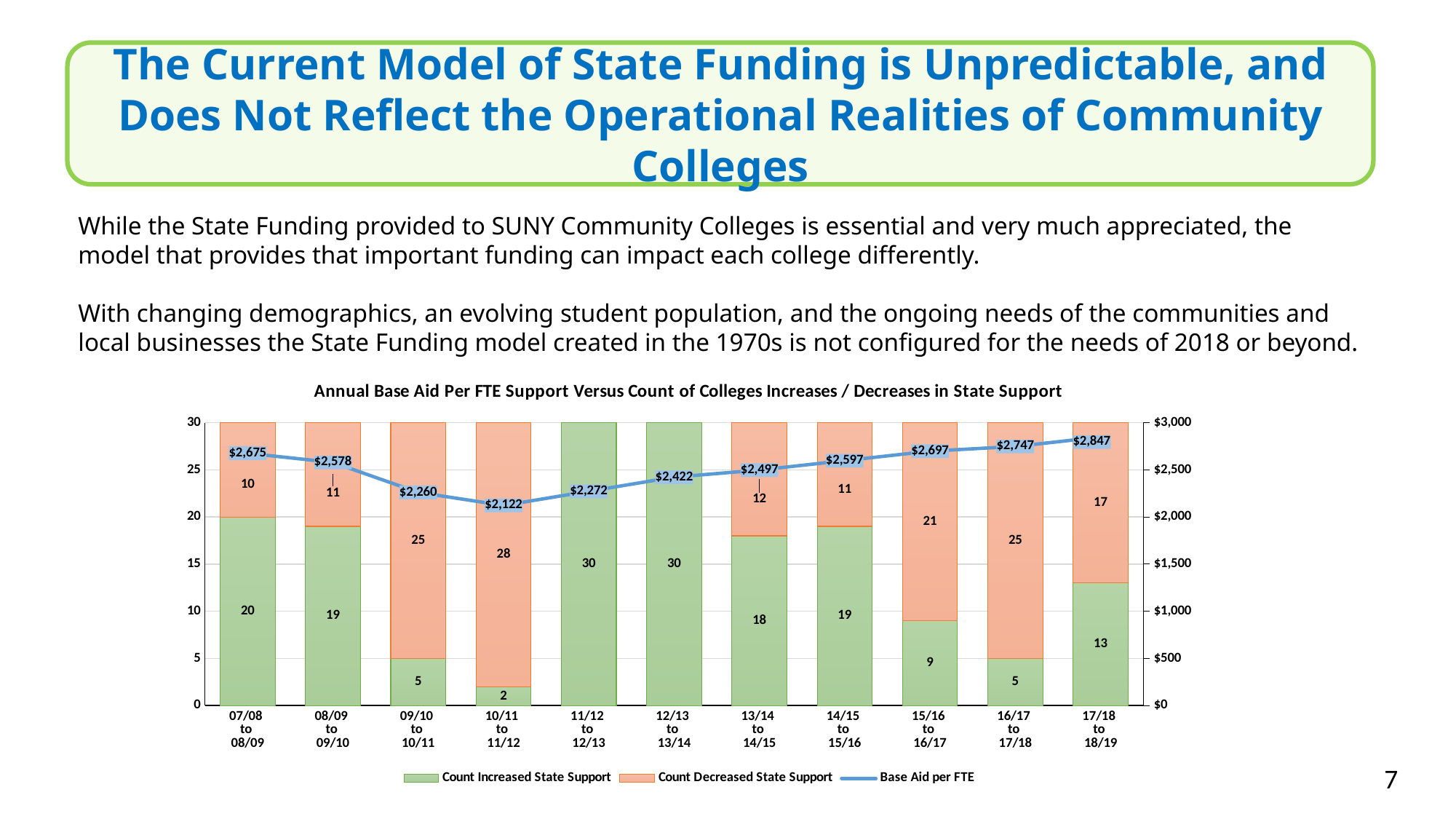
What kind of chart is shown on the slide? Stacked bar chart with a line Which is larger in 15/16 to 16/17: the count of colleges with increased state support or the count with decreased state support? Count Decreased State Support How many series does the legend list? 3 What is the title of the chart? Annual Base Aid Per FTE Support Versus Count of Colleges Increases / Decreases in State Support In which period is the Base Aid per FTE highest? 17/18 to 18/19 How many colleges had increased state support in 17/18 to 18/19? 13 Does the Base Aid per FTE rise or fall from 10/11 to 11/12 through 17/18 to 18/19? Rise How many periods are shown on the x axis? 11 In which period is the Base Aid per FTE lowest? 10/11 to 11/12 What is the Base Aid per FTE value for 10/11 to 11/12? $2,122 What is the difference between the Base Aid per FTE in 17/18 to 18/19 and in 10/11 to 11/12? $725 What is the Count Decreased State Support value for 09/10 to 10/11? 25